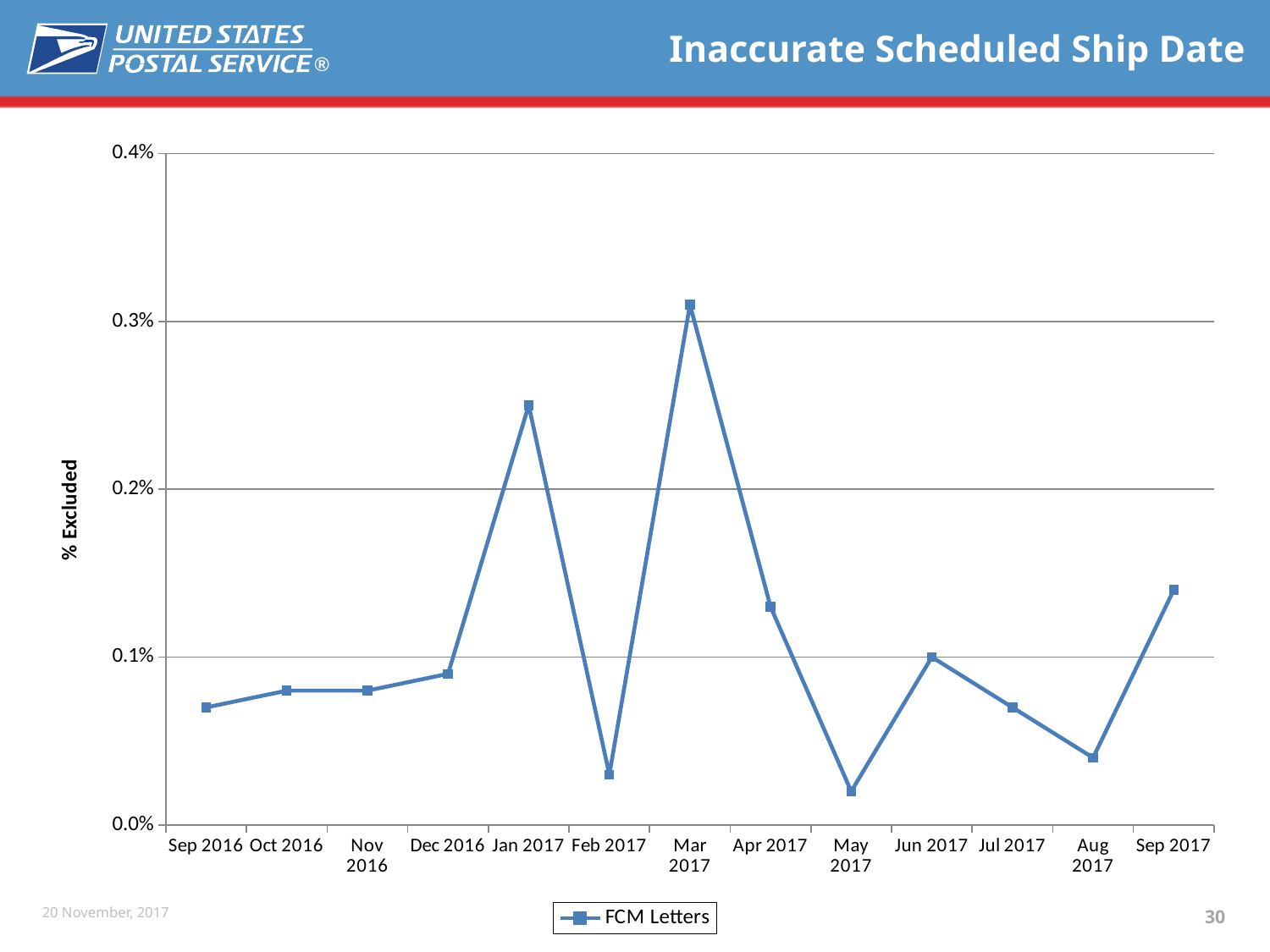
How many series does the legend list? 1 How many months are plotted on the x axis? 13 Which month has the lowest % Excluded value? May 2017 Do the values rise or fall from Sep 2016 to Dec 2016? rise Which is larger, the value for Jan 2017 or the value for Apr 2017? Jan 2017 Which month has the highest % Excluded value? Mar 2017 Is the value for Jan 2017 greater or less than 0.2%? greater Is the value for Feb 2017 greater or less than 0.1%? less What series name is shown in the legend? FCM Letters What kind of chart is shown on the slide? line chart Is the value for Sep 2017 greater or less than 0.1%? greater